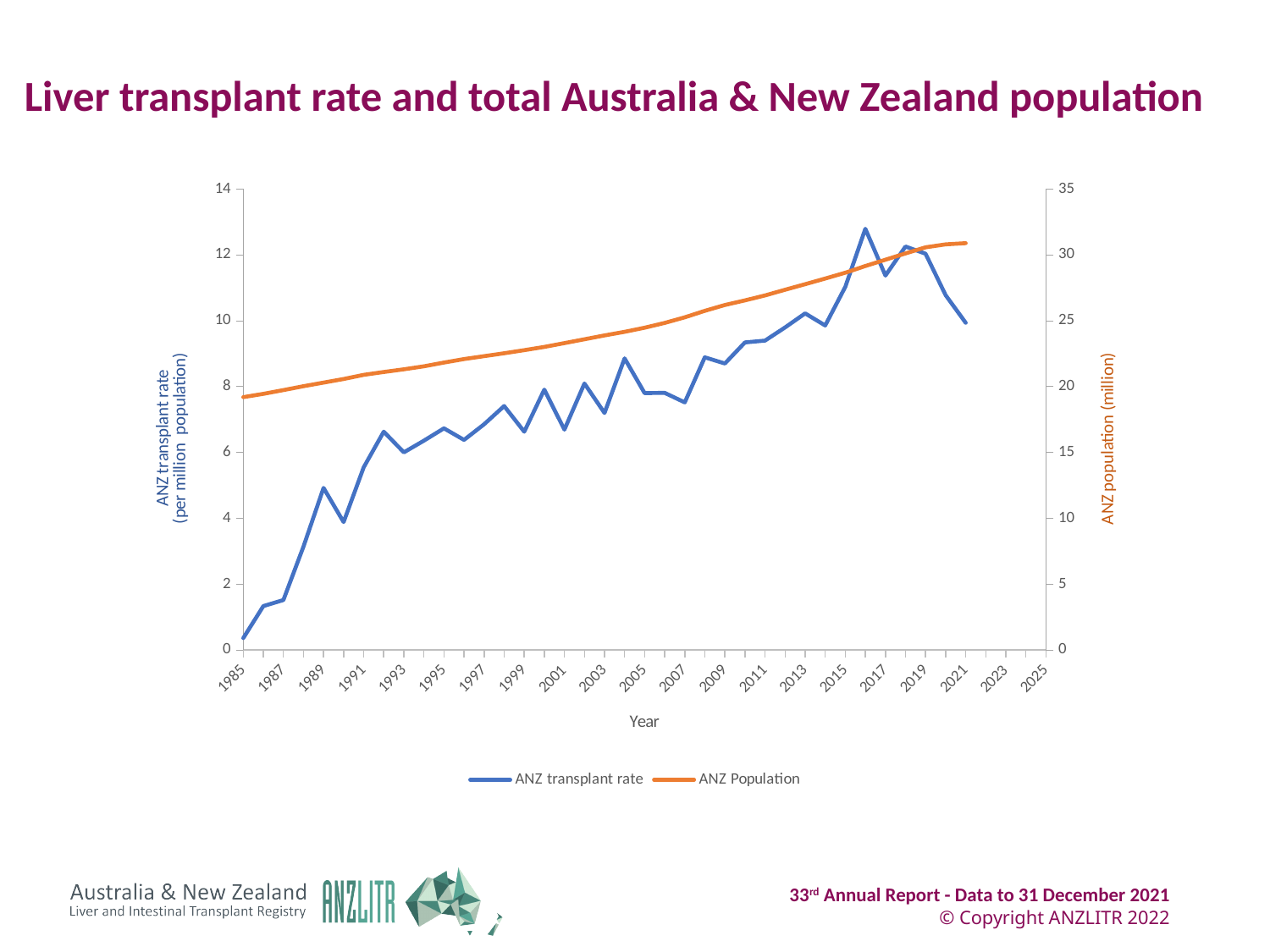
Is the ANZ population in 2013 greater or less than 25 million? greater Is the ANZ transplant rate in 1990 greater or less than 6? less Which is larger, the ANZ transplant rate in 2016 or in 2021? 2016 How many series does the legend list? 2 What kind of chart is shown on the slide? Line chart In which year does the ANZ transplant rate reach its highest value? 2016 Is the ANZ transplant rate in 2016 greater or less than 12? greater Which series is drawn in orange? ANZ Population In which year is the ANZ transplant rate at its lowest? 1985 What is the title of the chart? Liver transplant rate and total Australia & New Zealand population Does the ANZ population rise or fall from 1985 to 2021? Rises